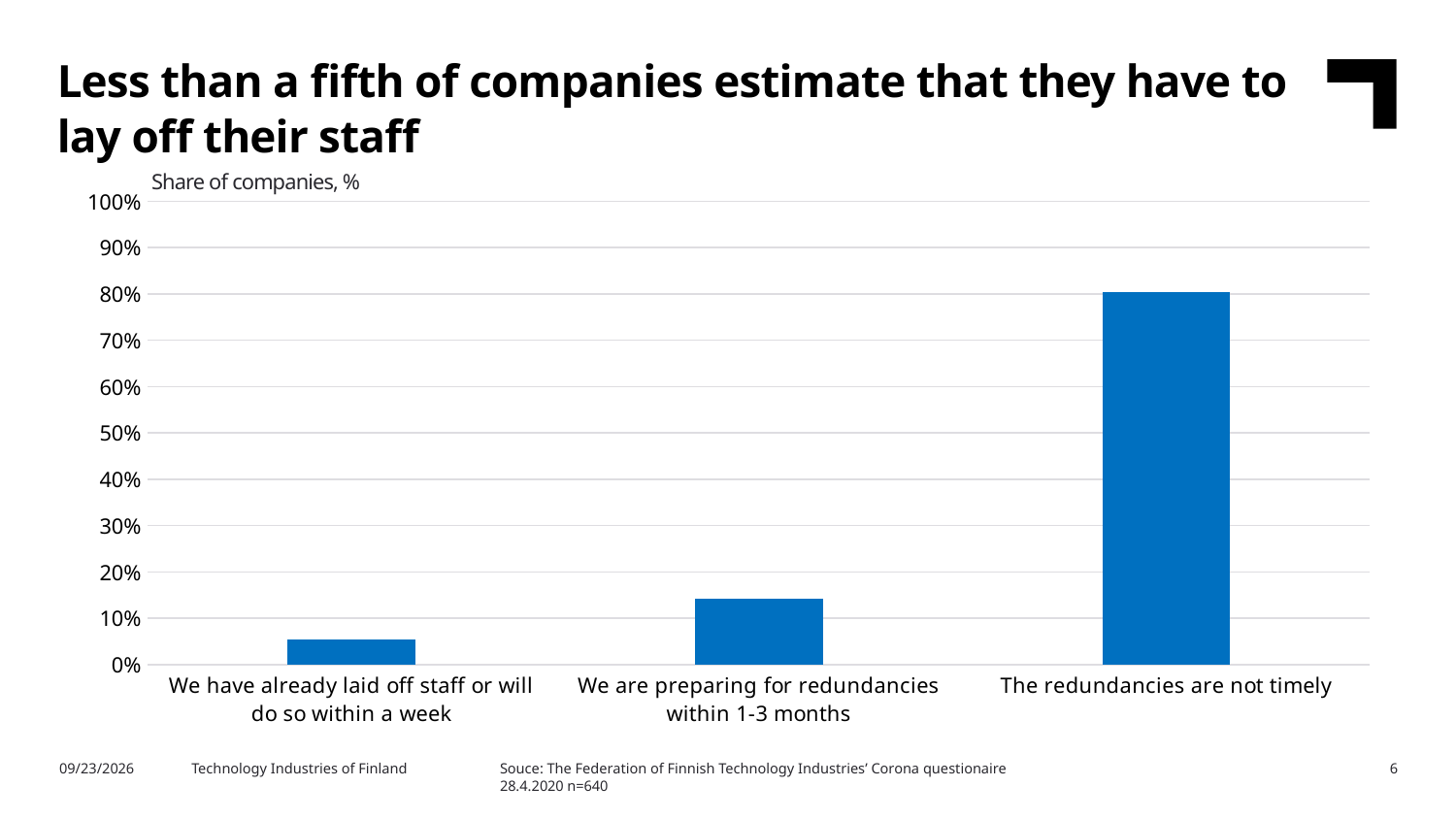
Is the value for 'The redundancies are not timely' greater or less than 70%? greater Which category has the highest share of companies? The redundancies are not timely How many categories are shown on the x axis of the chart? 3 Is the value for 'We are preparing for redundancies within 1-3 months' greater or less than 20%? less What is the label of the y axis of the chart? Share of companies, % Is the value for 'We are preparing for redundancies within 1-3 months' greater or less than 10%? greater Which category has the lowest share of companies? We have already laid off staff or will do so within a week What kind of chart is shown on the slide? bar chart What is the title of the slide containing the chart? Less than a fifth of companies estimate that they have to lay off their staff Which is larger: the share for 'We are preparing for redundancies within 1-3 months' or the share for 'We have already laid off staff or will do so within a week'? We are preparing for redundancies within 1-3 months Do the values rise or fall from left to right along the x axis? rise